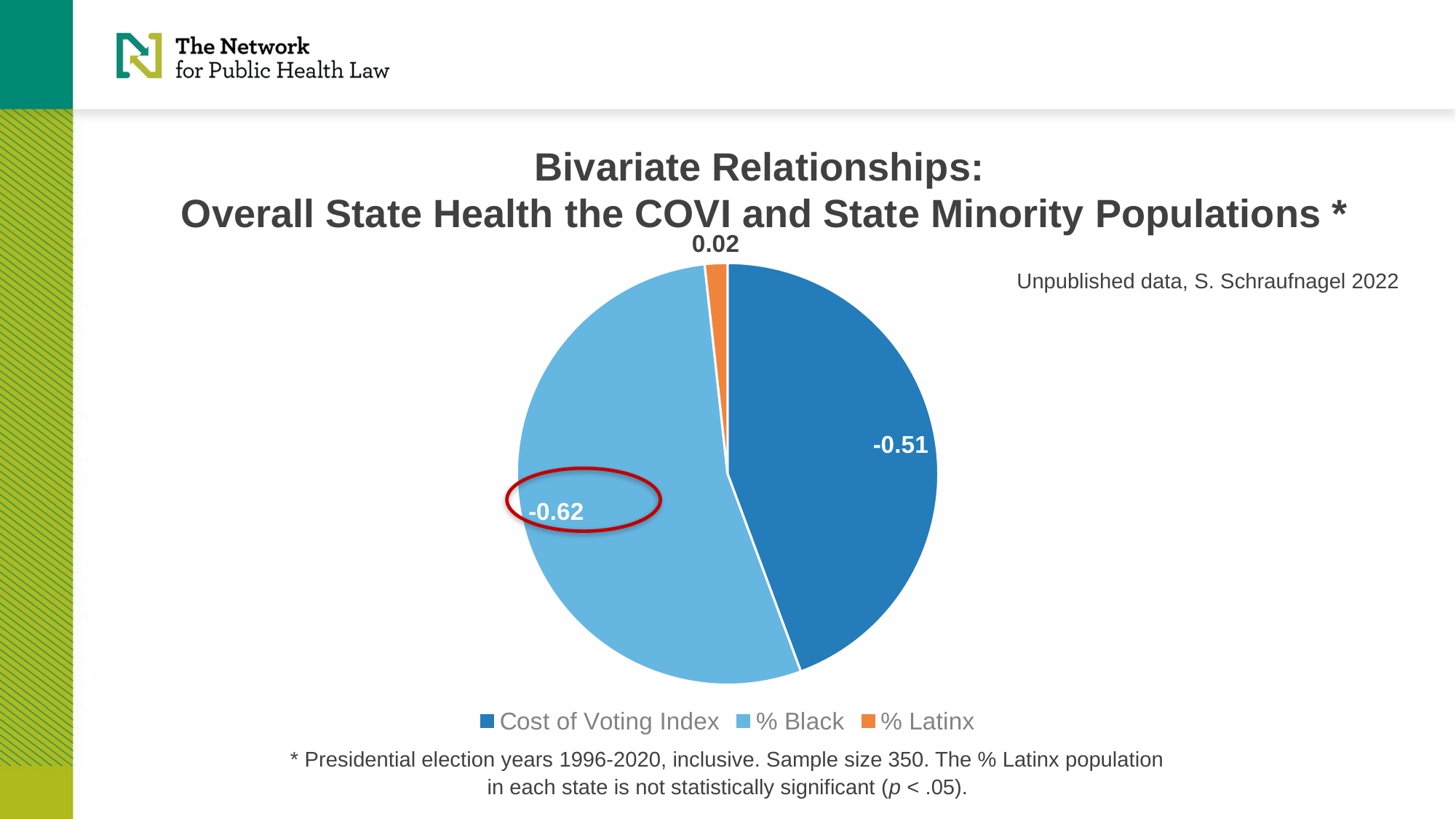
What type of chart is shown on the slide? pie chart Which slice takes up the largest portion of the pie? % Black What is the value shown for the Cost of Voting Index slice? -0.51 How many slices does the pie chart have? 3 Which slice is larger in the pie: Cost of Voting Index or % Latinx? Cost of Voting Index What is the value shown for the % Black slice? -0.62 What colour is the % Latinx slice? orange What is the difference between the values for Cost of Voting Index and % Black? 0.11 What is the value shown for the % Latinx slice? 0.02 Which data label on the pie chart is circled in red? -0.62 Which slice takes up the smallest portion of the pie? % Latinx How many entries does the legend list? 3